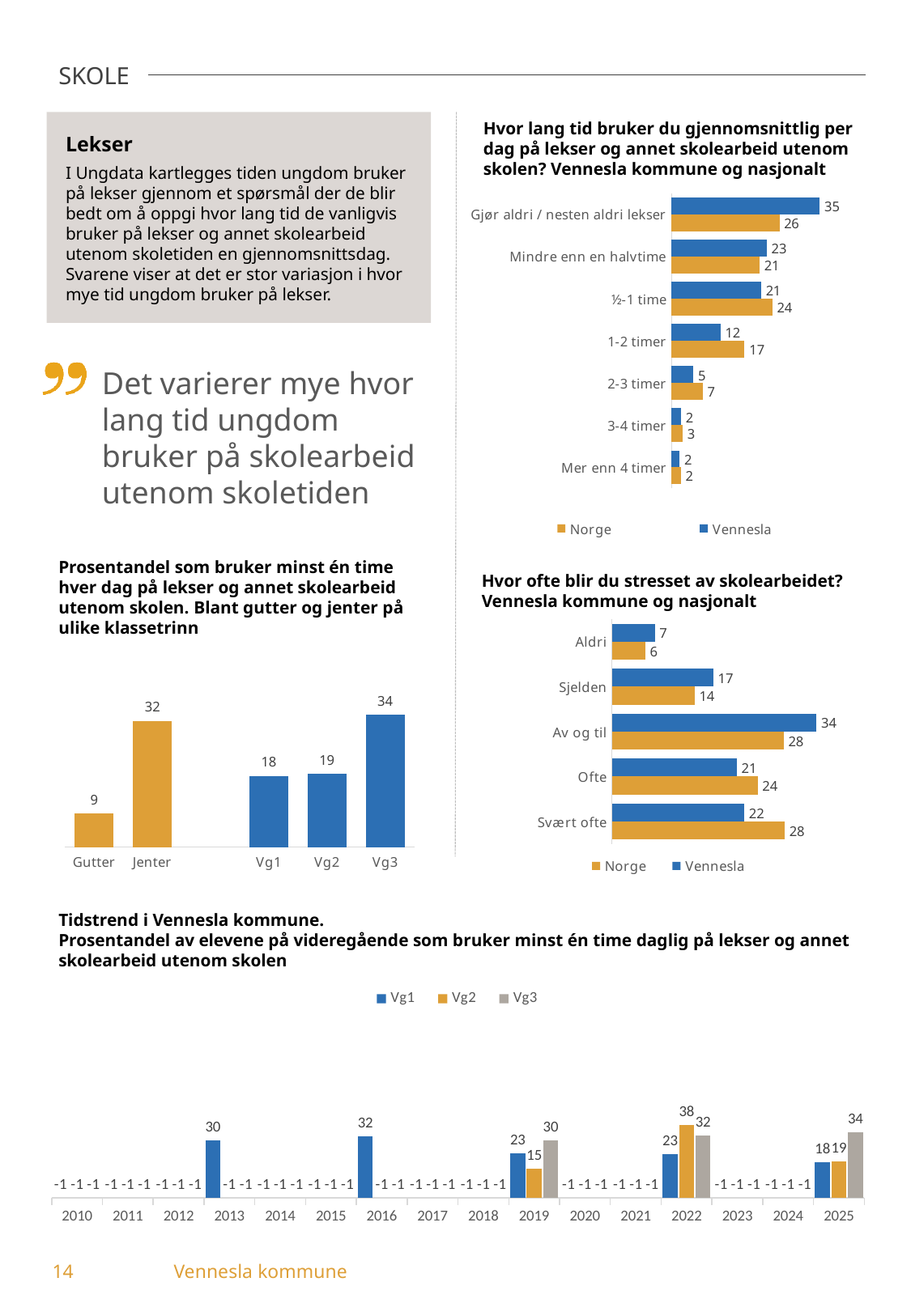
In the chart 'Prosentandel som bruker minst én time hver dag på lekser og annet skolearbeid utenom skolen', which category has the highest value? Vg3 In the chart 'Hvor ofte blir du stresset av skolearbeidet?', which is larger for 'Ofte': Norge or Vennesla? Norge In the chart 'Tidstrend i Vennesla kommune', what is the Vg2 value for 2022? 38 In the chart 'Hvor lang tid bruker du gjennomsnittlig per dag på lekser og annet skolearbeid utenom skolen?', how many series does the legend list? 2 In the chart 'Prosentandel som bruker minst én time hver dag på lekser og annet skolearbeid utenom skolen', how many categories are shown? 5 In the chart 'Prosentandel som bruker minst én time hver dag på lekser og annet skolearbeid utenom skolen', what is the value for Gutter? 9 In the chart 'Tidstrend i Vennesla kommune', what is the Vg3 value for 2025? 34 In the chart 'Hvor lang tid bruker du gjennomsnittlig per dag på lekser og annet skolearbeid utenom skolen?', what is the Vennesla value for 'Gjør aldri / nesten aldri lekser'? 35 In the chart 'Hvor ofte blir du stresset av skolearbeidet?', what is the Norge value for 'Svært ofte'? 28 In the chart 'Hvor lang tid bruker du gjennomsnittlig per dag på lekser og annet skolearbeid utenom skolen?', what is the difference between the Vennesla and Norge values for 'Gjør aldri / nesten aldri lekser'? 9 In the chart 'Hvor lang tid bruker du gjennomsnittlig per dag på lekser og annet skolearbeid utenom skolen?', what is the Norge value for '1-2 timer'? 17 In the chart 'Hvor ofte blir du stresset av skolearbeidet?', what kind of chart is it? Bar chart